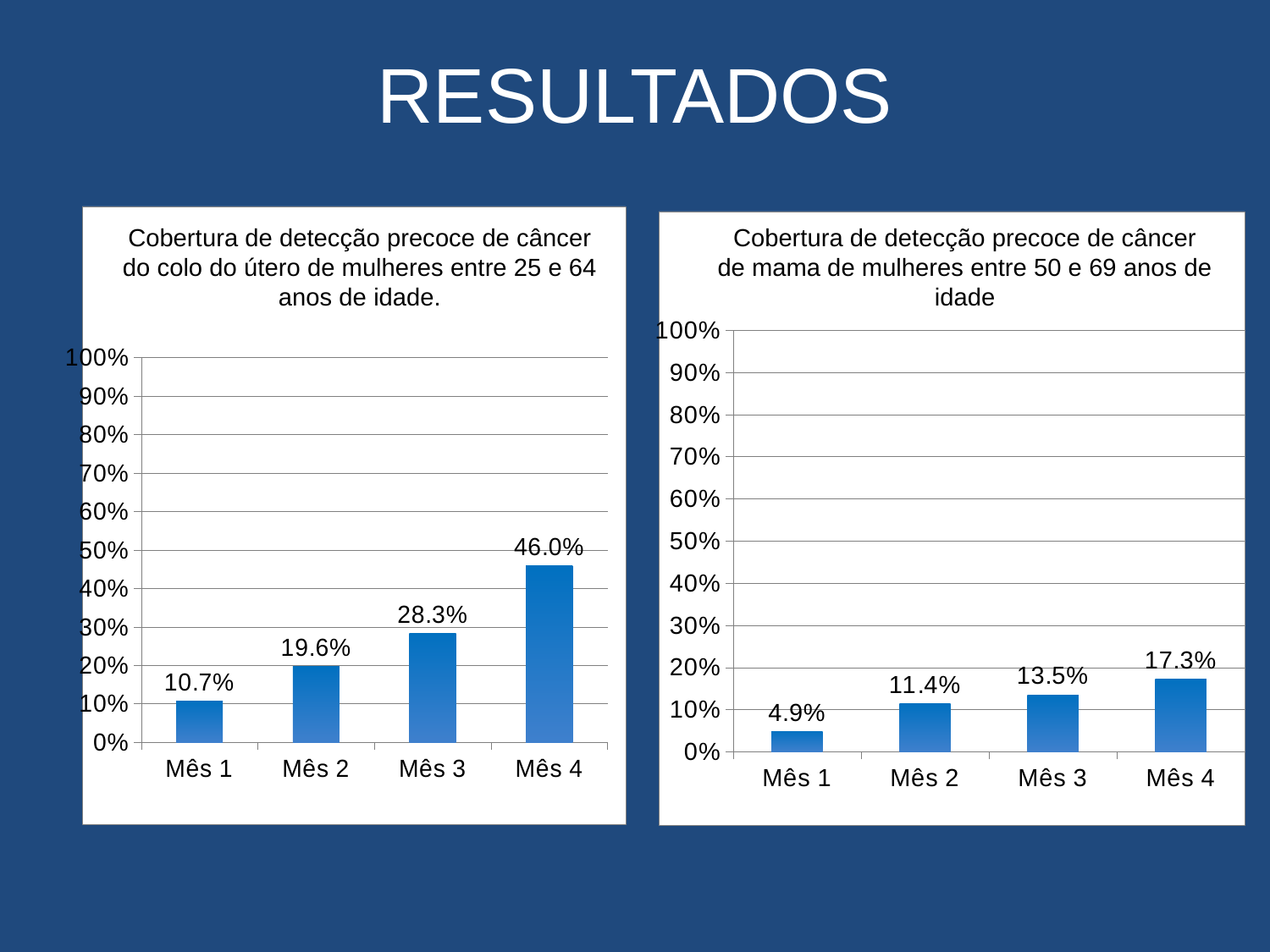
In the left chart (cervical cancer detection coverage), what is the difference between the values for Mês 4 and Mês 3? 17.7% In the left chart (cervical cancer detection coverage), do the values rise or fall from Mês 1 to Mês 4? rise What kind of chart is the right chart (breast cancer detection coverage)? bar chart In the left chart (cervical cancer detection coverage), which month has the lowest value? Mês 1 In the left chart (cervical cancer detection coverage), what is the value for Mês 4? 46.0% In the right chart (breast cancer detection coverage), which month has the highest value? Mês 4 What is the title of the right chart? Cobertura de detecção precoce de câncer de mama de mulheres entre 50 e 69 anos de idade In the right chart (breast cancer detection coverage), what is the difference between the values for Mês 4 and Mês 1? 12.4% How many months are shown on the x axis of the left chart (cervical cancer detection coverage)? 4 Which is larger: the value for Mês 3 in the left chart or the value for Mês 3 in the right chart? Mês 3 in the left chart In the right chart (breast cancer detection coverage), is the value for Mês 4 greater or less than 20%? less In the right chart (breast cancer detection coverage), what is the value for Mês 2? 11.4%